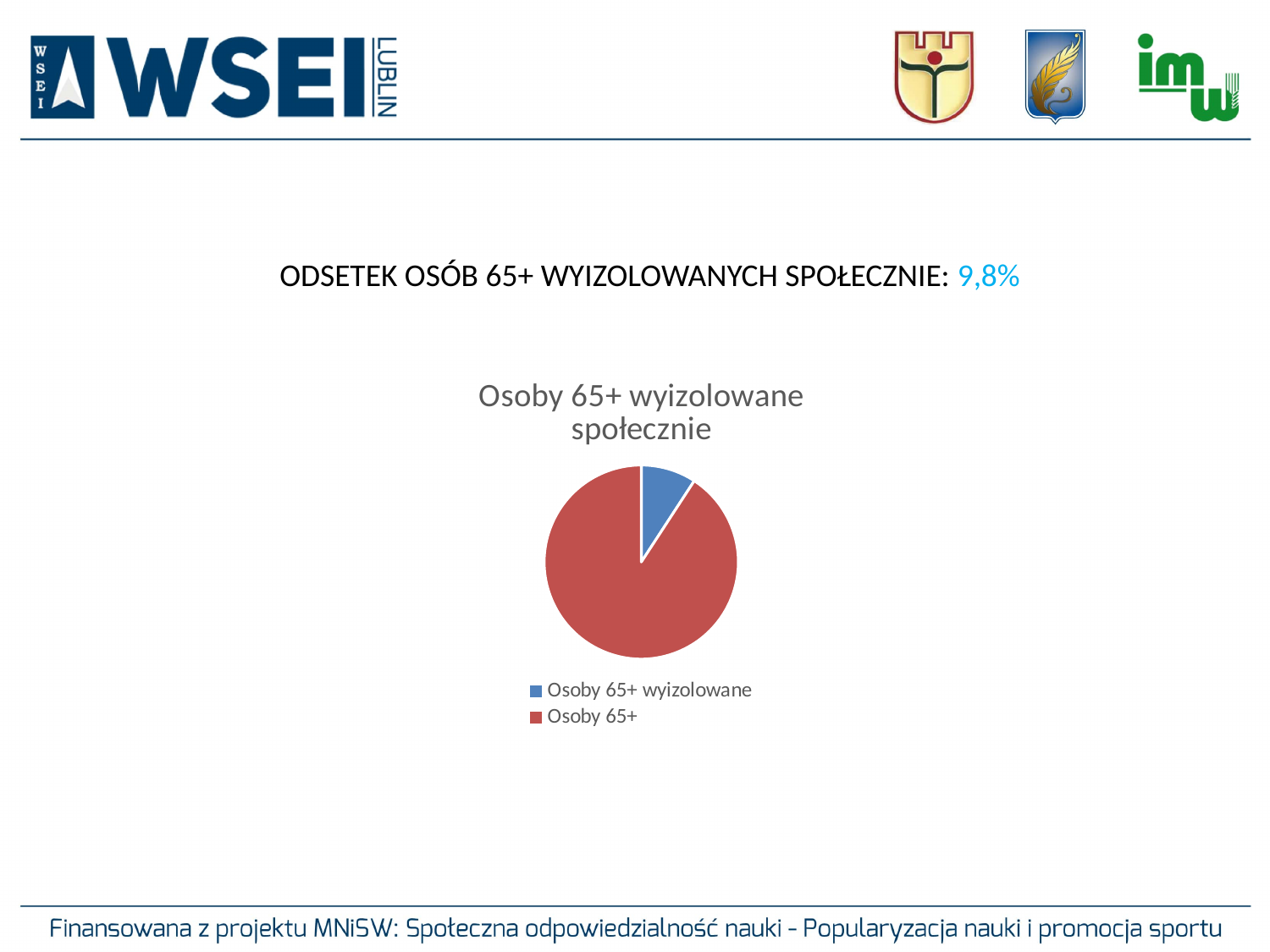
What is the title of the pie chart? Osoby 65+ wyizolowane społecznie What kind of chart is shown on the slide? pie chart According to the slide, what share of people aged 65+ are socially isolated (the "Osoby 65+ wyizolowane" slice)? 9,8% How many slices does the pie chart have? 2 Which slice of the pie chart is the smallest? Osoby 65+ wyizolowane What colour is the "Osoby 65+ wyizolowane" slice in the pie chart? blue How many entries does the legend of the pie chart list? 2 Which slice of the pie chart is the largest? Osoby 65+ Which slice is larger in the pie chart: "Osoby 65+ wyizolowane" or "Osoby 65+"? Osoby 65+